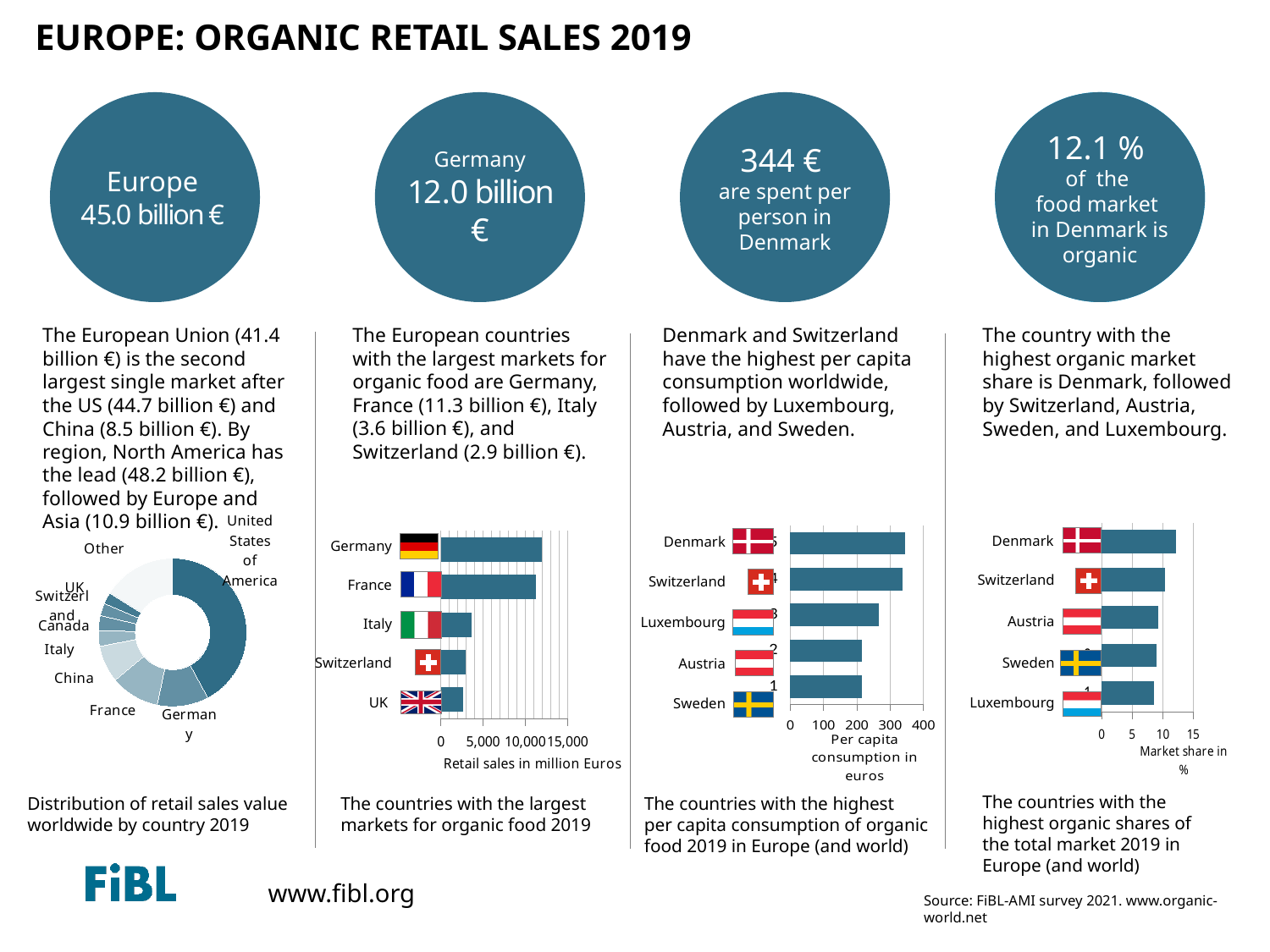
In the chart 'The countries with the largest markets for organic food 2019', is the value for Germany greater or less than 10,000? greater In the chart 'The countries with the highest organic shares of the total market 2019 in Europe (and world)', is the value for Denmark greater or less than 10? greater In the chart 'The countries with the highest organic shares of the total market 2019 in Europe (and world)', which country has the lowest market share? Luxembourg In the chart 'The countries with the largest markets for organic food 2019', which country has the lowest retail sales? UK In the chart 'The countries with the largest markets for organic food 2019', which is larger, the value for France or the value for Italy? France In the chart 'The countries with the highest per capita consumption of organic food 2019 in Europe (and world)', which country has the highest per capita consumption? Denmark What kind of chart is 'Distribution of retail sales value worldwide by country 2019'? Pie (donut) chart In the chart 'The countries with the highest per capita consumption of organic food 2019 in Europe (and world)', is the value for Sweden greater or less than 300? less How many countries are shown in the chart 'The countries with the largest markets for organic food 2019'? 5 In the chart 'The countries with the largest markets for organic food 2019', which country has the highest retail sales? Germany What is the x-axis label of the chart 'The countries with the largest markets for organic food 2019'? Retail sales in million Euros